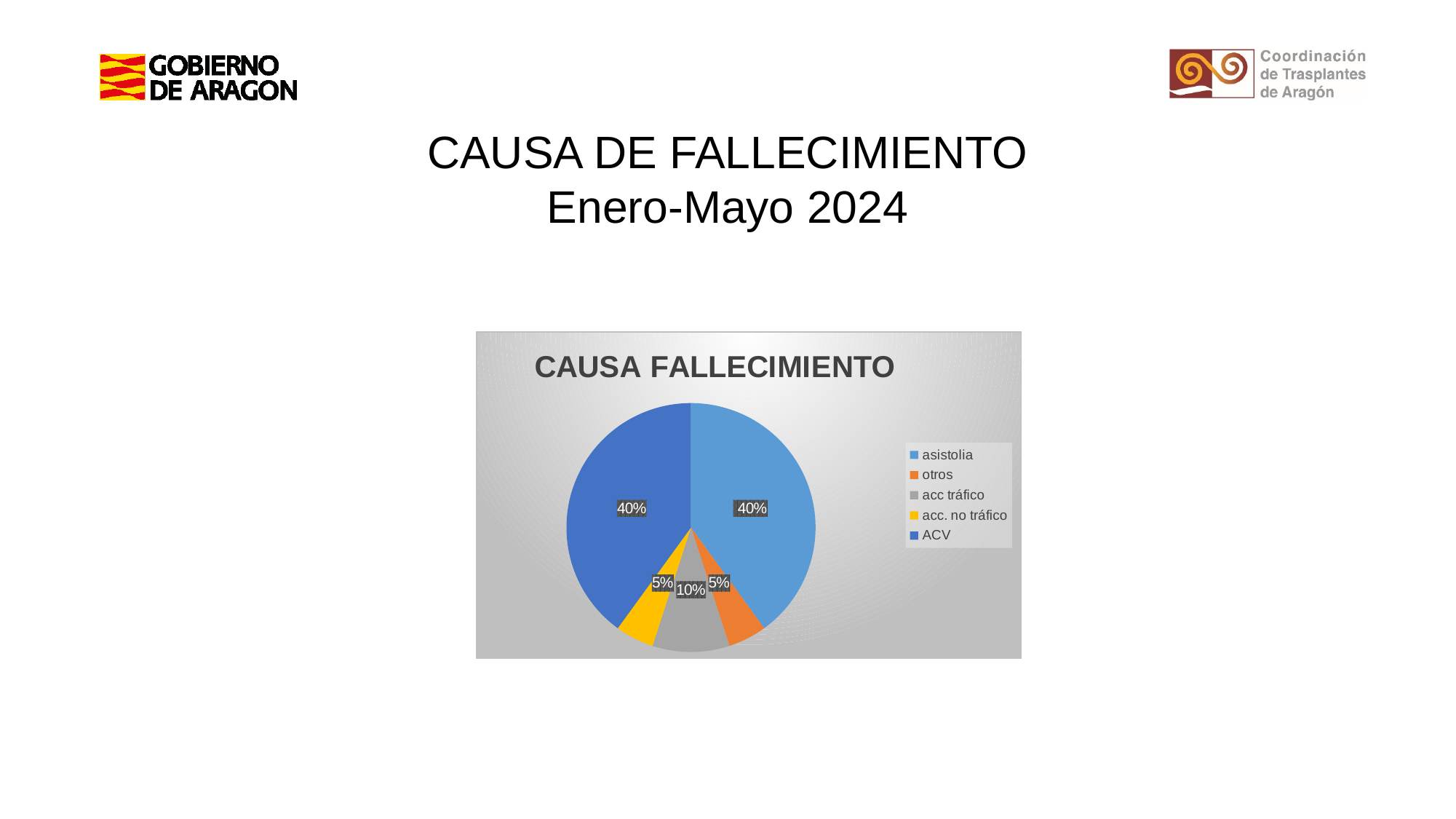
How many categories does the pie chart show? 5 Which is larger, the share for ACV or the share for acc tráfico? ACV What percentage of the pie chart does otros represent? 5% What type of chart is shown on the slide? pie chart What percentage of the pie chart does asistolia represent? 40% What percentage of the pie chart does ACV represent? 40% Which is larger, the share for acc tráfico or the share for acc. no tráfico? acc tráfico What is the title of the chart? CAUSA FALLECIMIENTO What is the difference in percentage points between acc tráfico and otros? 5 What percentage of the pie chart does acc tráfico represent? 10% What percentage of the pie chart does acc. no tráfico represent? 5% What is the difference in percentage points between asistolia and acc tráfico? 30